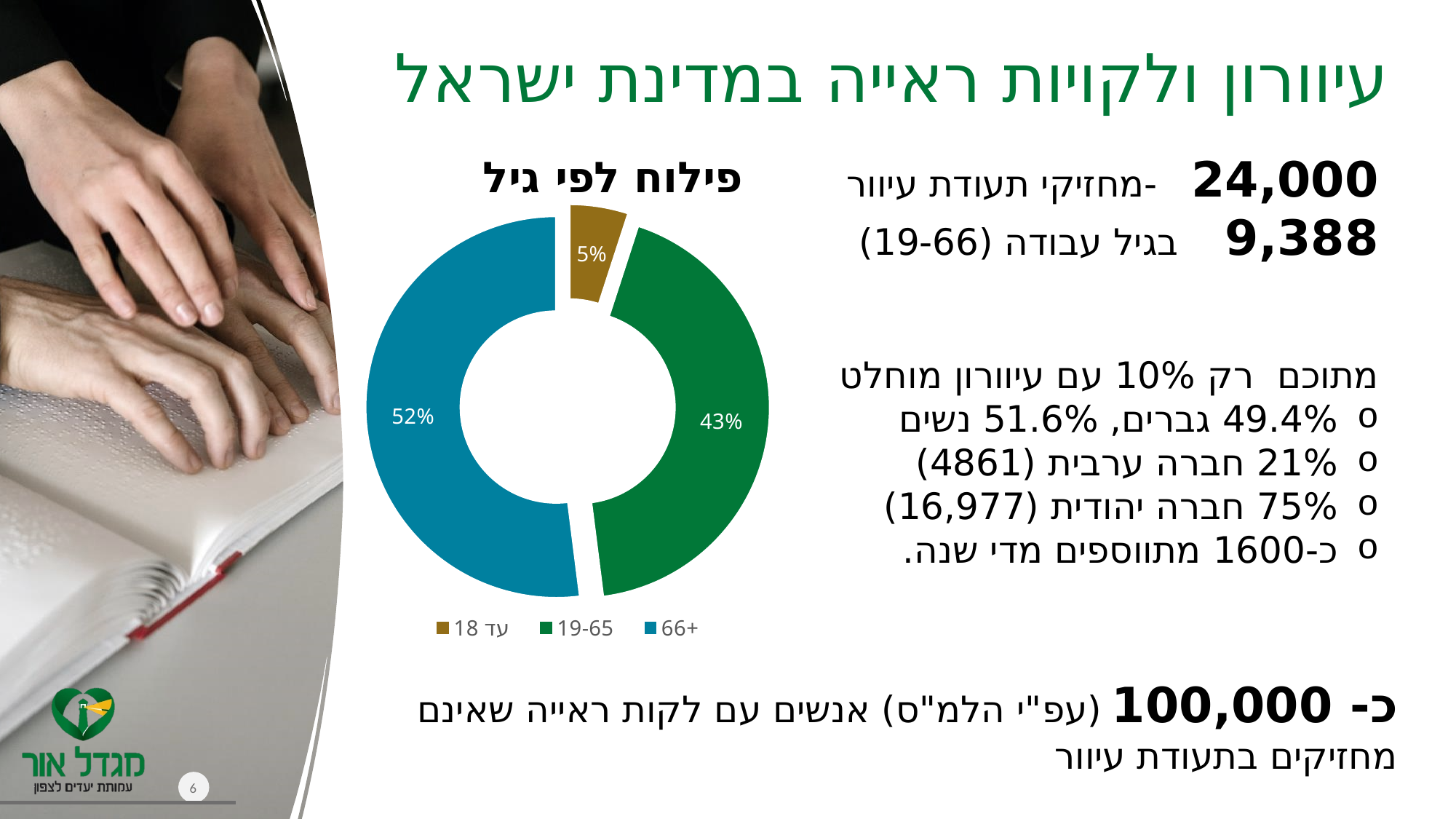
What is the title of the chart? פילוח לפי גיל How many age groups are shown in the doughnut chart? 3 What percentage of the doughnut chart is the 66+ age group? 52% Which age group has the smallest share in the doughnut chart? עד 18 What kind of chart is shown on the slide? Doughnut (pie) chart What is the difference in percentage points between the 66+ and 19-65 slices? 9 What is the difference in percentage points between the 19-65 and עד 18 slices? 38 What percentage of the doughnut chart is the עד 18 (up to 18) age group? 5% What percentage of the doughnut chart is the 19-65 age group? 43% How many entries does the chart legend list? 3 Which slice is larger, 19-65 or 66+? 66+ Which age group has the largest share in the doughnut chart? 66+